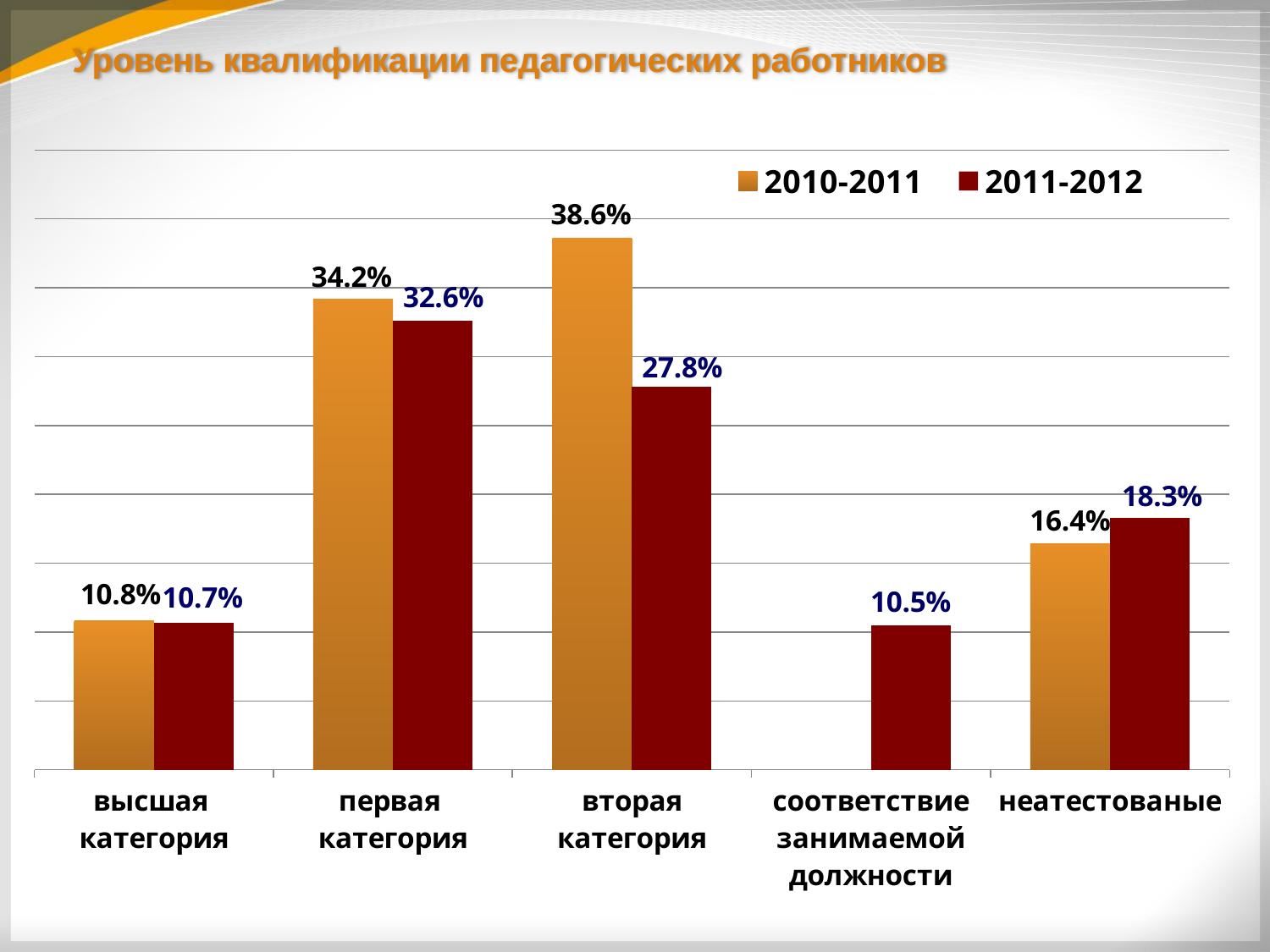
Which category has the lowest value in the 2011-2012 series? соответствие занимаемой должности How many categories are shown on the x axis? 5 What is the value for неатестованые in the 2010-2011 series? 16.4% What kind of chart is shown on the slide? bar chart What is the value for вторая категория in the 2011-2012 series? 27.8% Which category has the highest value in the 2010-2011 series? вторая категория What is the value for первая категория in the 2010-2011 series? 34.2% Which is larger for неатестованые: the 2010-2011 value or the 2011-2012 value? 2011-2012 What is the value for соответствие занимаемой должности in the 2011-2012 series? 10.5% What is the difference between the 2010-2011 and 2011-2012 values for вторая категория? 10.8% What is the title of the slide? Уровень квалификации педагогических работников How many series does the legend list? 2